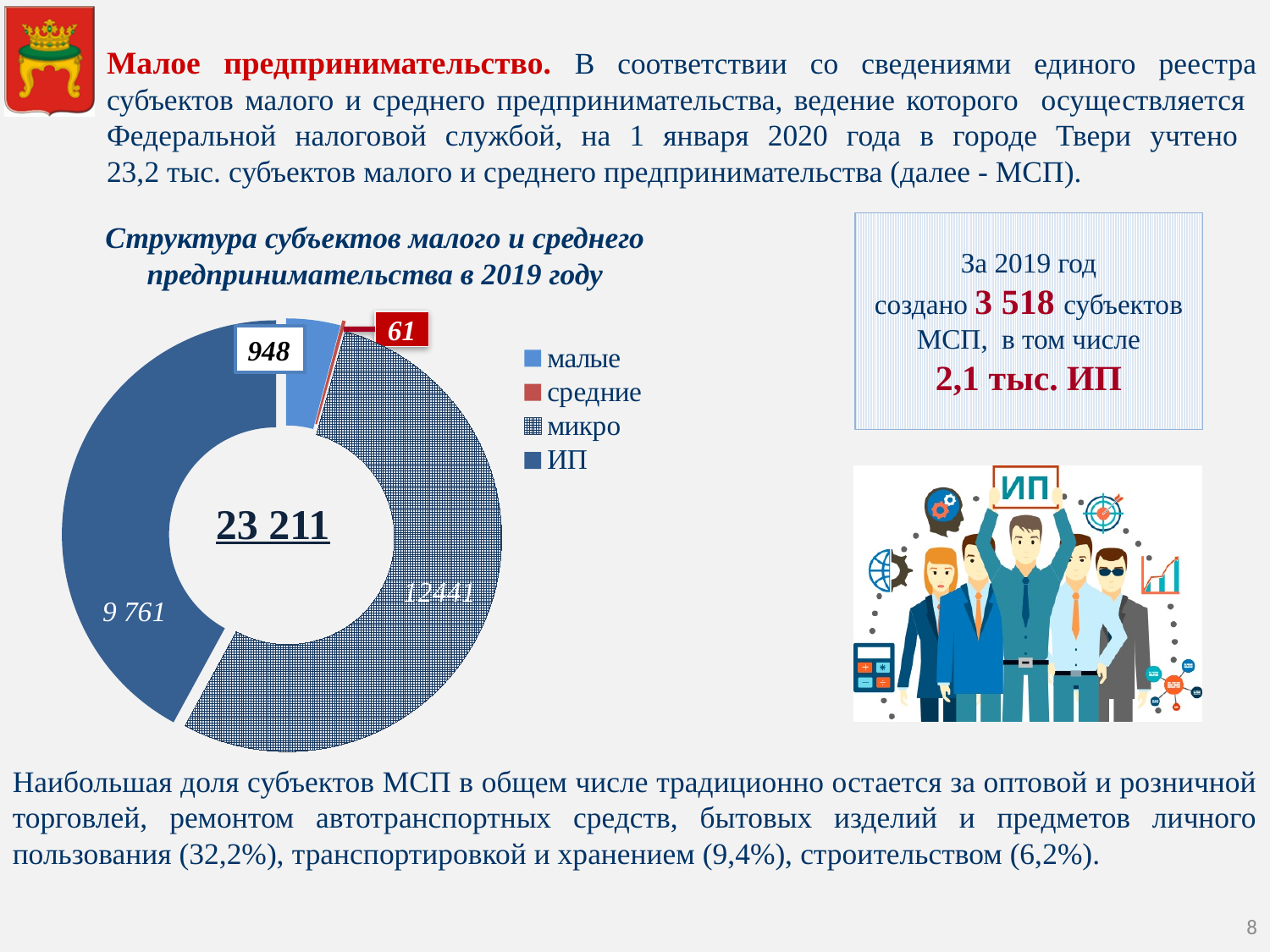
Which is larger, the value for малые or the value for средние? малые What is the value for the средние segment in the chart? 61 What kind of chart is shown on the slide? Doughnut (pie) chart What is the value for the ИП segment in the chart? 9 761 What total is shown in the centre of the doughnut chart? 23 211 What is the title of the chart? Структура субъектов малого и среднего предпринимательства в 2019 году Which category has the largest segment in the chart? микро What is the value for the малые segment in the chart? 948 What is the value for the микро segment in the chart? 12441 Which category has the smallest segment in the chart? средние How many categories does the legend of the chart list? 4 What is the difference between the микро and ИП values? 2680